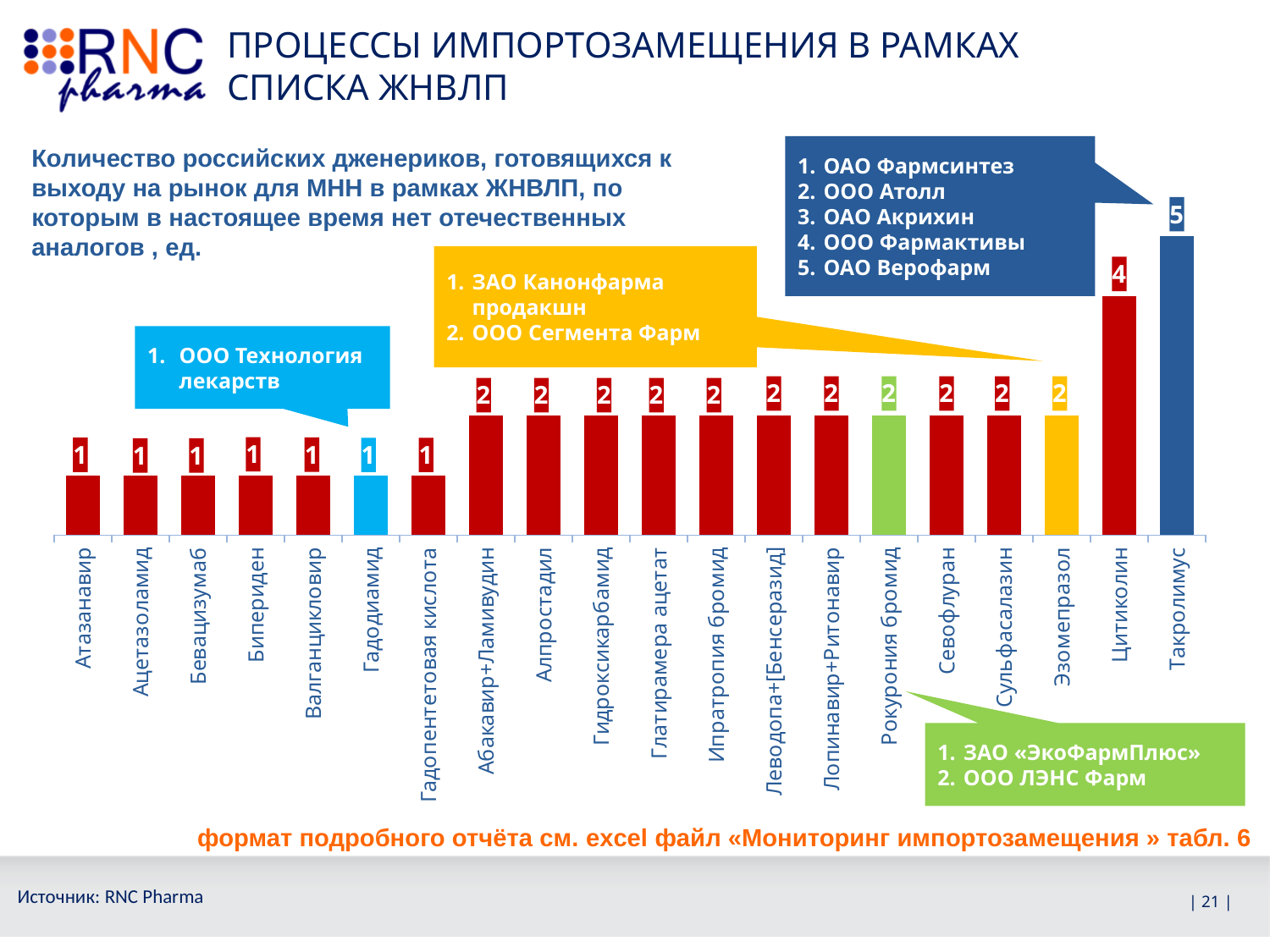
What is the difference between the values for Цитиколин and Атазанавир? 3 What is the value for Цитиколин? 4 Which company is named in the callout pointing to the Гадодиамид bar? ООО Технология лекарств Do the values rise or fall moving from left to right along the x axis? rise How many categories are shown on the x axis? 20 What is the value for Такролимус? 5 What is the difference between the values for Такролимус and Цитиколин? 1 Which is larger, the value for Эзомепразол or the value for Бипериден? Эзомепразол What kind of chart is shown on the slide? bar chart What is the value for Севофлуран? 2 Which category has the highest value? Такролимус What is the value for Гадодиамид? 1